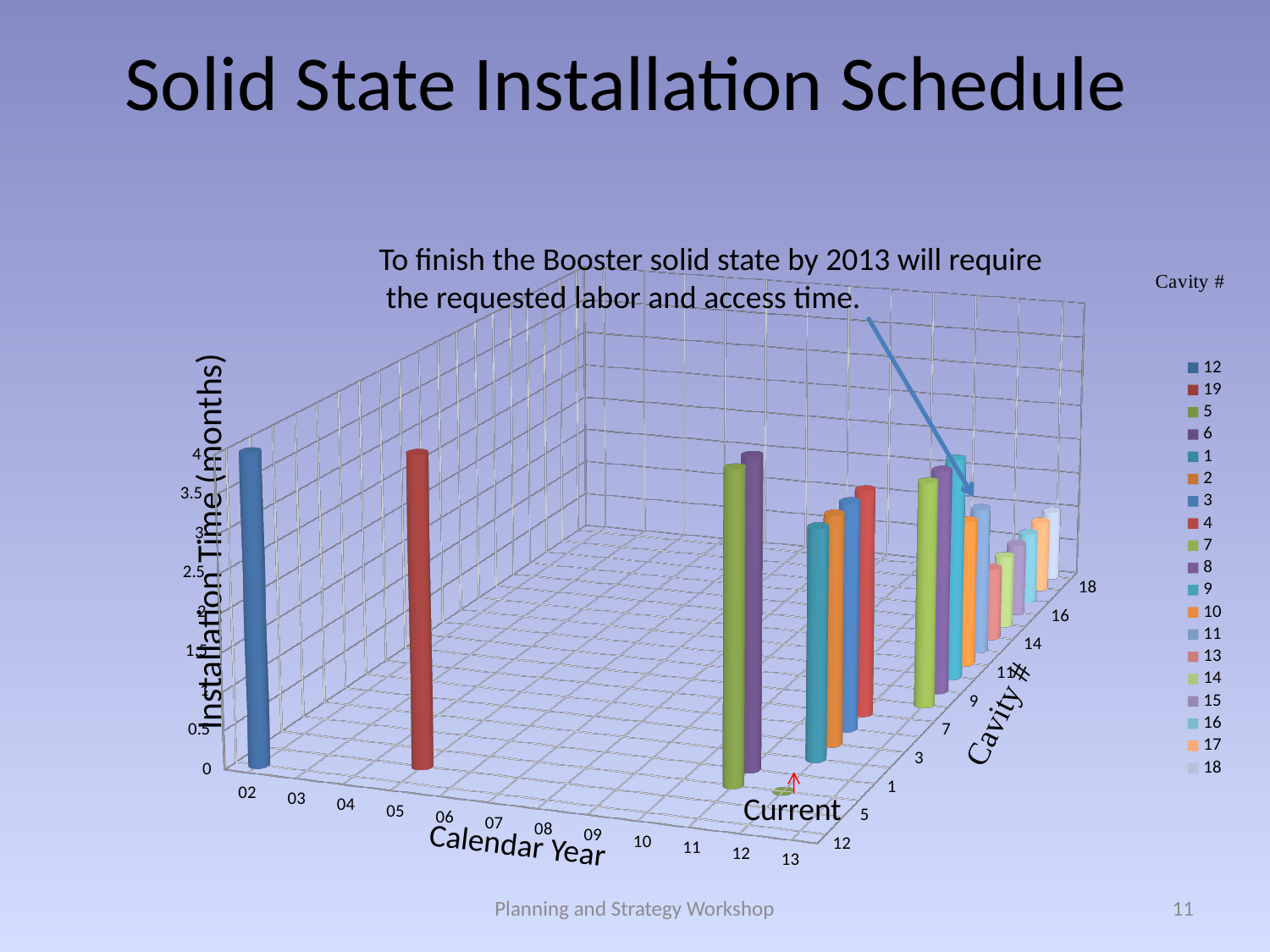
What is the first calendar year shown on the x axis? 02 How many calendar year categories are shown along the x axis? 12 What is the title of the legend on the chart? Cavity # Is the installation time for the bar in calendar year 05 greater or less than 1 month? greater What is the label of the vertical axis? Installation Time (months) Which cavity number is listed first in the legend? 12 What kind of chart is shown on the slide? bar chart Is the installation time for the bar in calendar year 02 greater or less than 2 months? greater What is the highest value shown on the Installation Time axis? 4 Which cavity number is listed last in the legend? 18 How many cavity numbers does the legend list? 19 What is the last calendar year shown on the x axis? 13